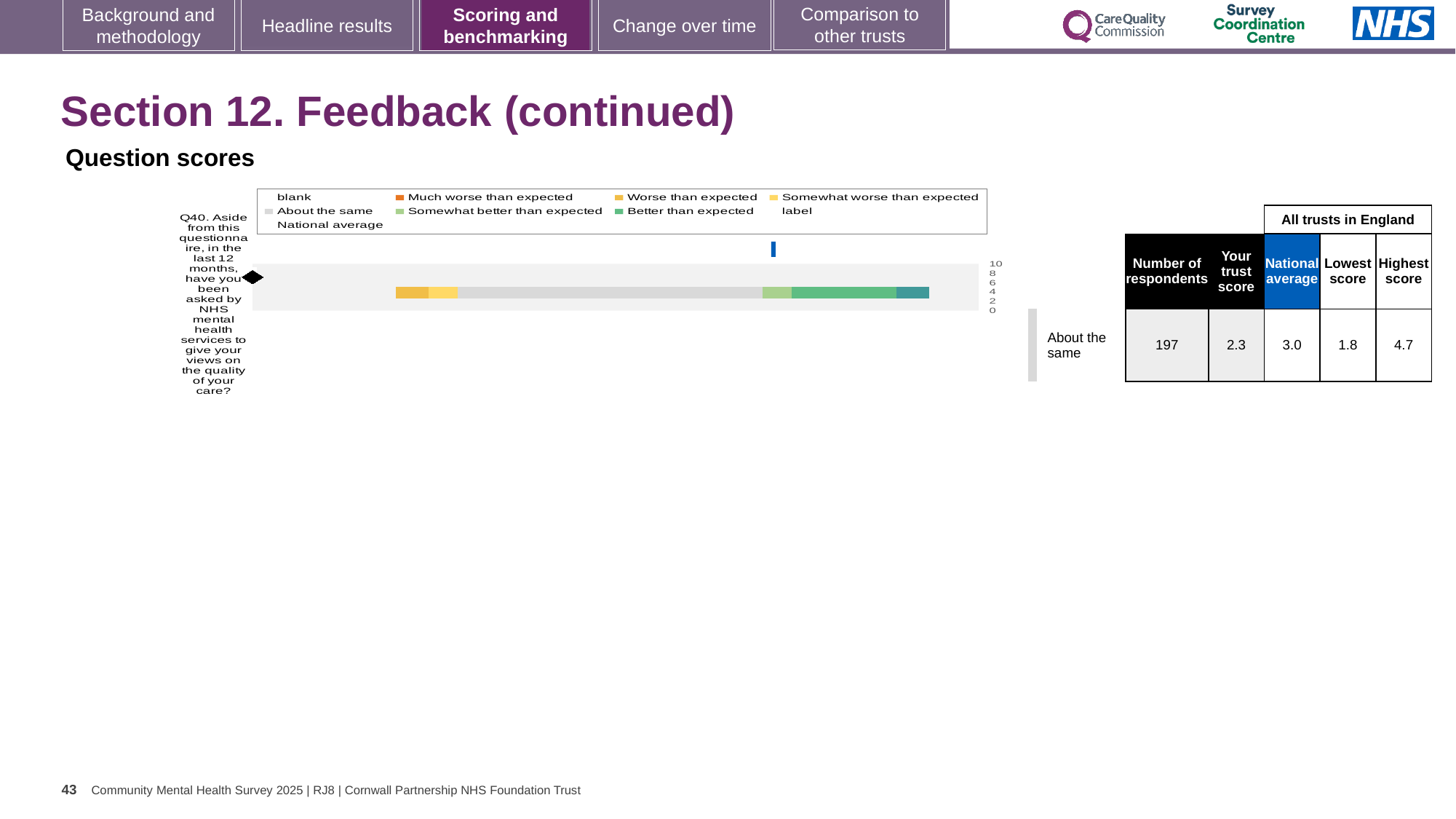
What is the number of respondents for Q40? 197 What is the difference between the national average and the trust's score for Q40? 0.7 Which question number is plotted in the chart? Q40 What is the trust's score for Q40? 2.3 What is the difference between the highest and lowest scores among all trusts in England for Q40? 2.9 What is the highest score among all trusts in England for Q40? 4.7 What is the lowest score among all trusts in England for Q40? 1.8 What kind of chart is shown on the slide? bar chart What is the national average score for Q40? 3.0 Which is larger for Q40, the trust's score or the national average? national average How many survey questions are plotted in the chart? 1 What benchmark category is shown next to the bar for Q40? About the same